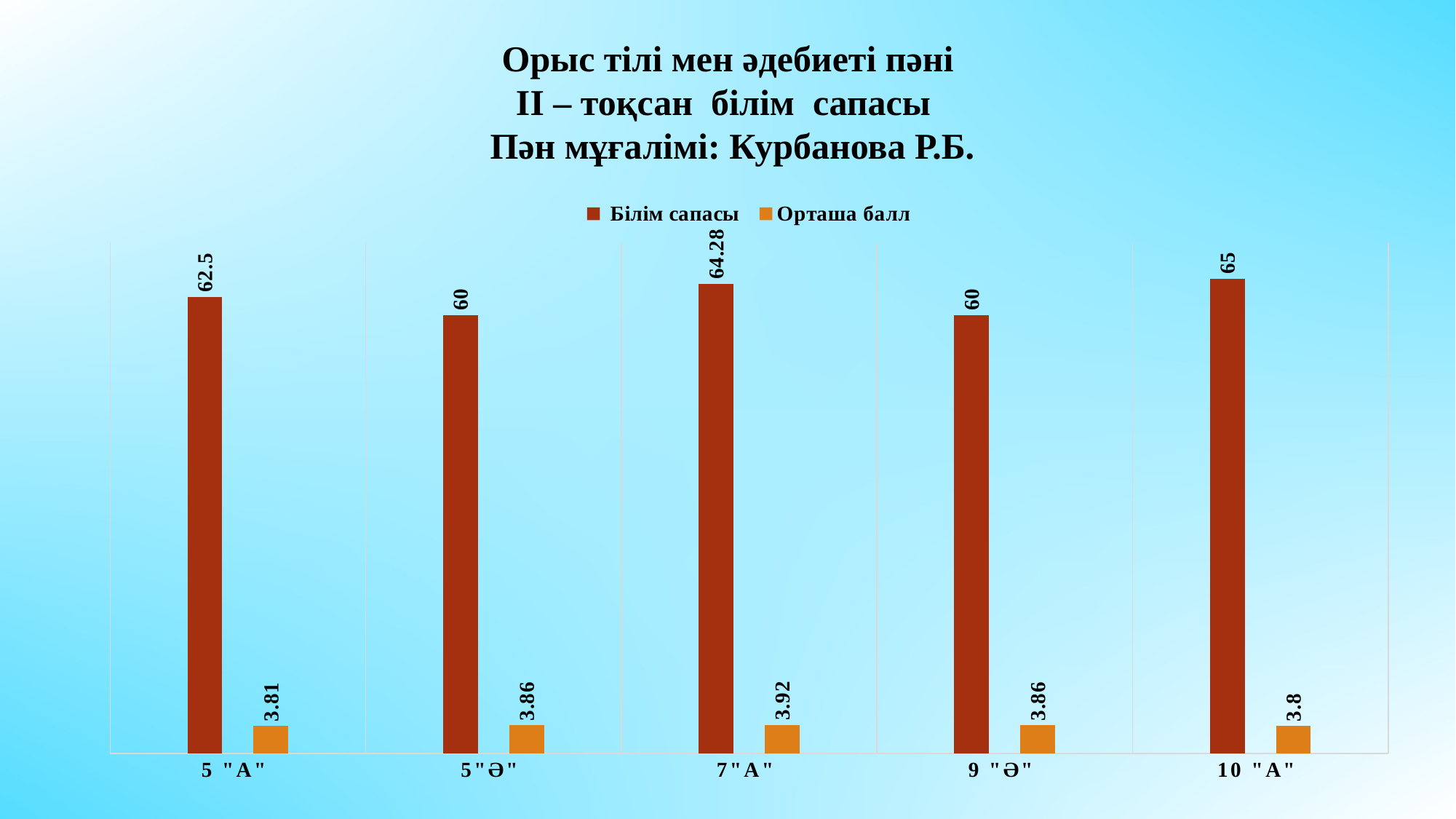
Which class has the highest Орташа балл value? 7 "А" Which class has the lowest Орташа балл value? 10 "А" What is the difference between the Білім сапасы values for 10 "А" and 5 "А"? 2.5 What is the Білім сапасы value for 7 "А"? 64.28 What is the Орташа балл value for 9 "Ә"? 3.86 Which class has the highest Білім сапасы value? 10 "А" Which is larger, the Білім сапасы value for 5 "А" or for 5 "Ә"? 5 "А" What is the Орташа балл value for 5 "А"? 3.81 How many classes are shown on the x axis? 5 What kind of chart is shown on the slide? Bar chart Which series is shown in orange in the legend? Орташа балл How many series does the legend list? 2